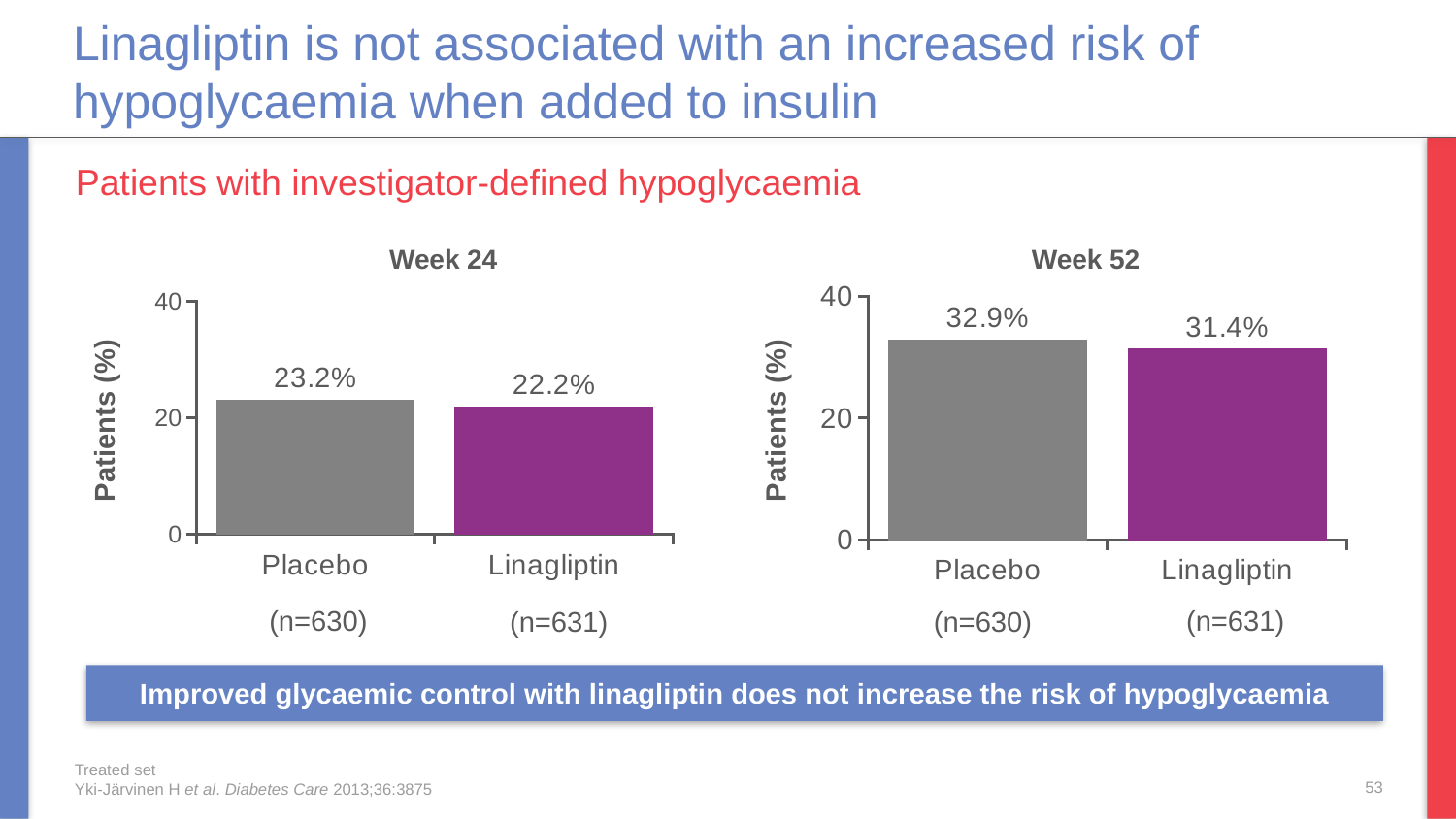
How many bars are shown in the Week 24 chart? 2 In the Week 52 chart, what is the difference between the Placebo and Linagliptin values? 1.5% In the Week 24 chart, what is the difference between the Placebo and Linagliptin values? 1.0% In the Week 24 chart, what percentage of patients in the Placebo group had investigator-defined hypoglycaemia? 23.2% In the Week 24 chart, what is the value for Linagliptin? 22.2% In the Week 52 chart, what is the value for Placebo? 32.9% What is the y-axis label on the Week 24 chart? Patients (%) What type of chart is the Week 52 chart? Bar chart In the Week 24 chart, which group has the lower value? Linagliptin In the Week 52 chart, is the value for Linagliptin greater or less than 20? greater In the Week 52 chart, what is the value for Linagliptin? 31.4% In the Week 52 chart, which group has the higher percentage of patients with hypoglycaemia? Placebo